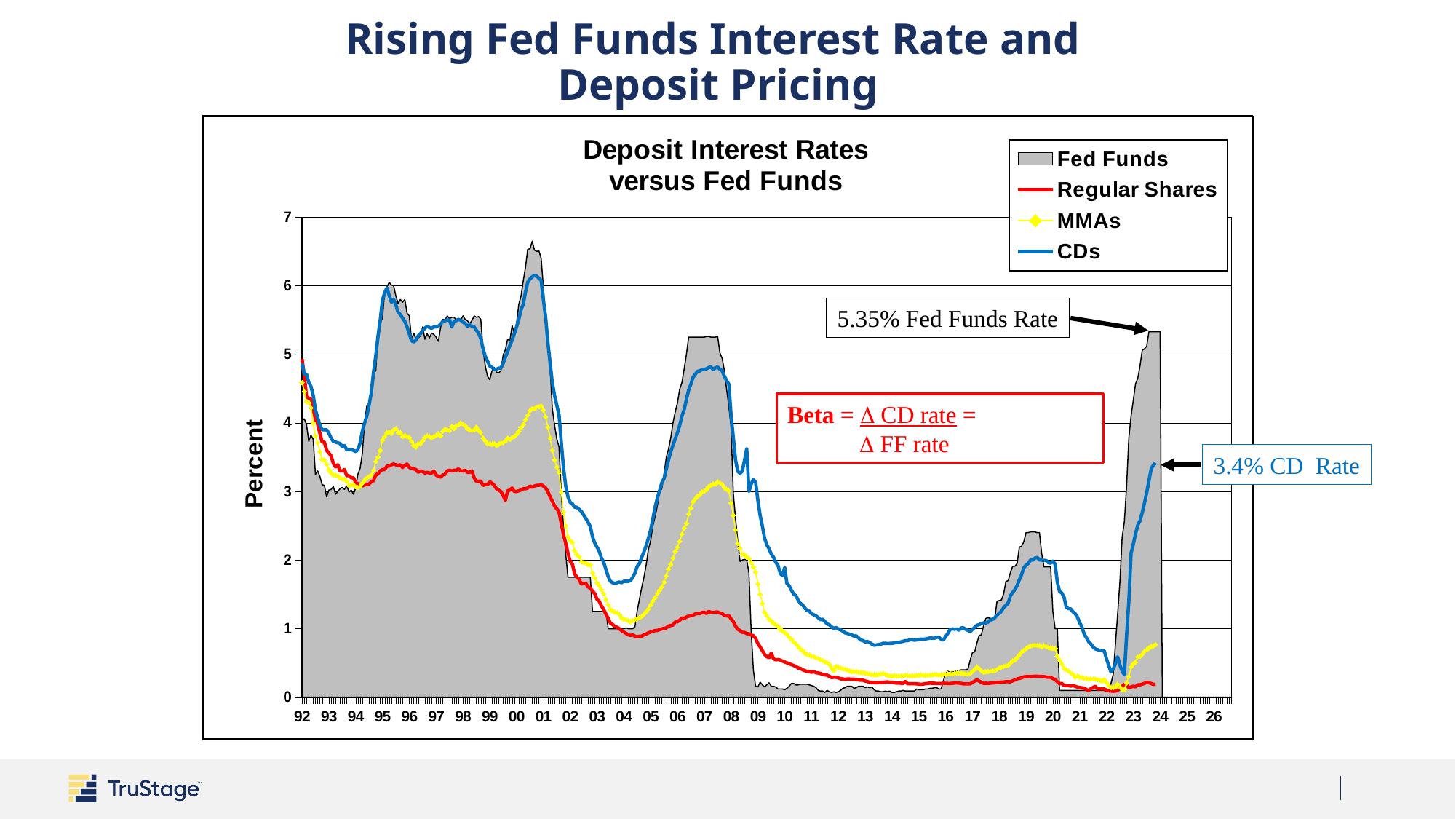
What kind of chart is shown on the slide? combination area and line chart What is the difference between the annotated Fed Funds rate (5.35%) and the annotated CD rate (3.4%)? 1.95% What Fed Funds rate is annotated at the right end of the chart? 5.35% Which colour represents CDs in the chart? blue Is the peak Fed Funds value around 2001 greater or less than 6? greater At the right end of the chart (2024), which is higher, Fed Funds or CDs? Fed Funds What is the title of the chart? Deposit Interest Rates versus Fed Funds What CD rate is annotated at the right end of the chart? 3.4% How many series does the chart legend list? 4 Is the CDs value around 2014 greater or less than 1? less Is the Regular Shares value around 1996 greater or less than 3? greater Between 2007 and 2009, does the Fed Funds series rise or fall? fall